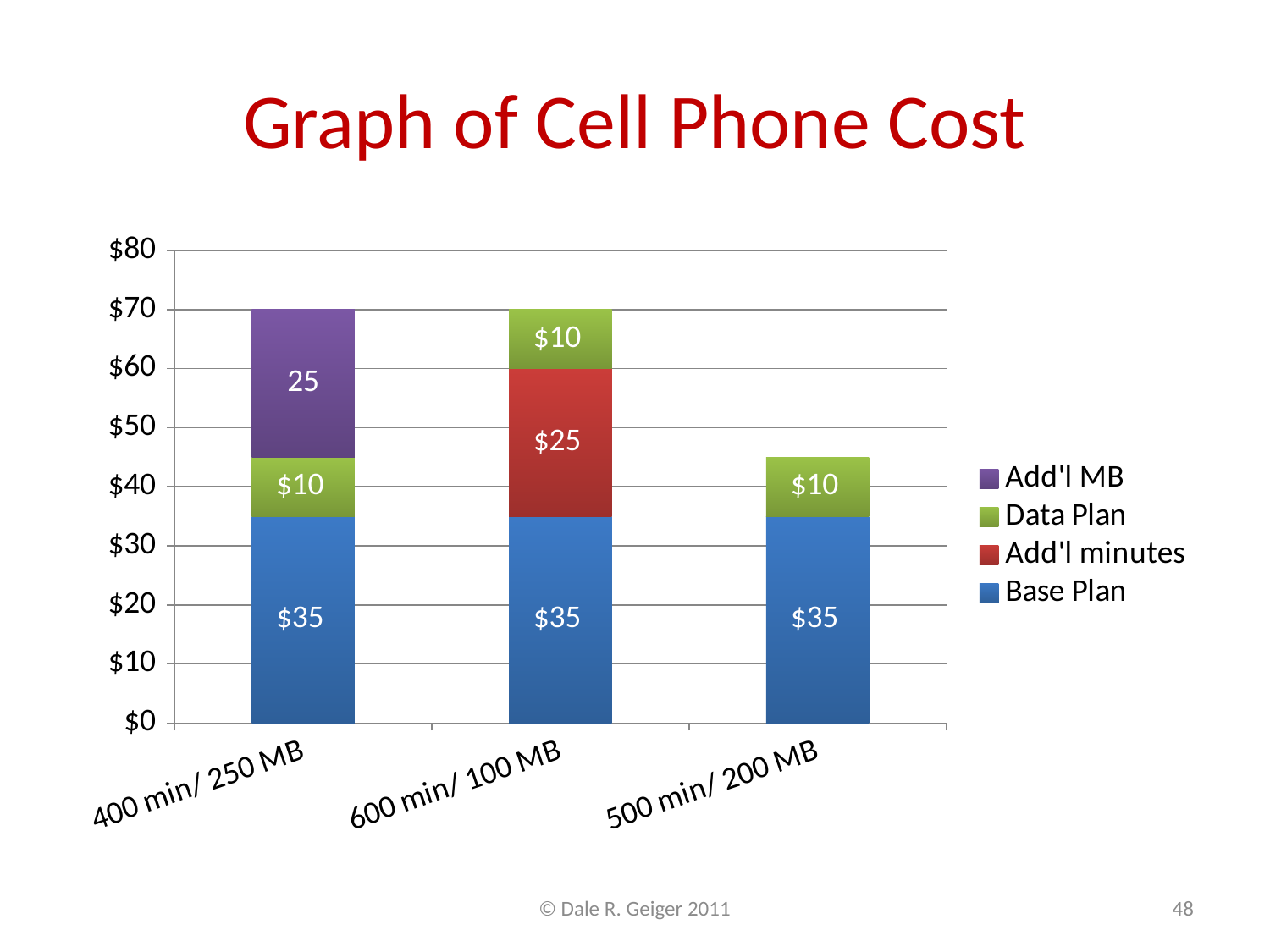
Which plan has the lowest total cost? 500 min/ 200 MB What is the title of the chart? Graph of Cell Phone Cost What kind of chart is shown on the slide? Stacked bar chart What is the Base Plan cost for the 600 min/ 100 MB plan? $35 How many plan categories are shown on the x axis? 3 How many series does the legend list? 4 What is the difference between the total cost of the 600 min/ 100 MB plan and the 500 min/ 200 MB plan? $25 What is the Data Plan cost for the 500 min/ 200 MB plan? $10 Which has the larger total cost, the 400 min/ 250 MB plan or the 500 min/ 200 MB plan? 400 min/ 250 MB What is the Add'l minutes cost for the 600 min/ 100 MB plan? $25 What is the total cost of the stacked bar for the 500 min/ 200 MB plan? $45 What is the total cost of the stacked bar for the 600 min/ 100 MB plan? $70